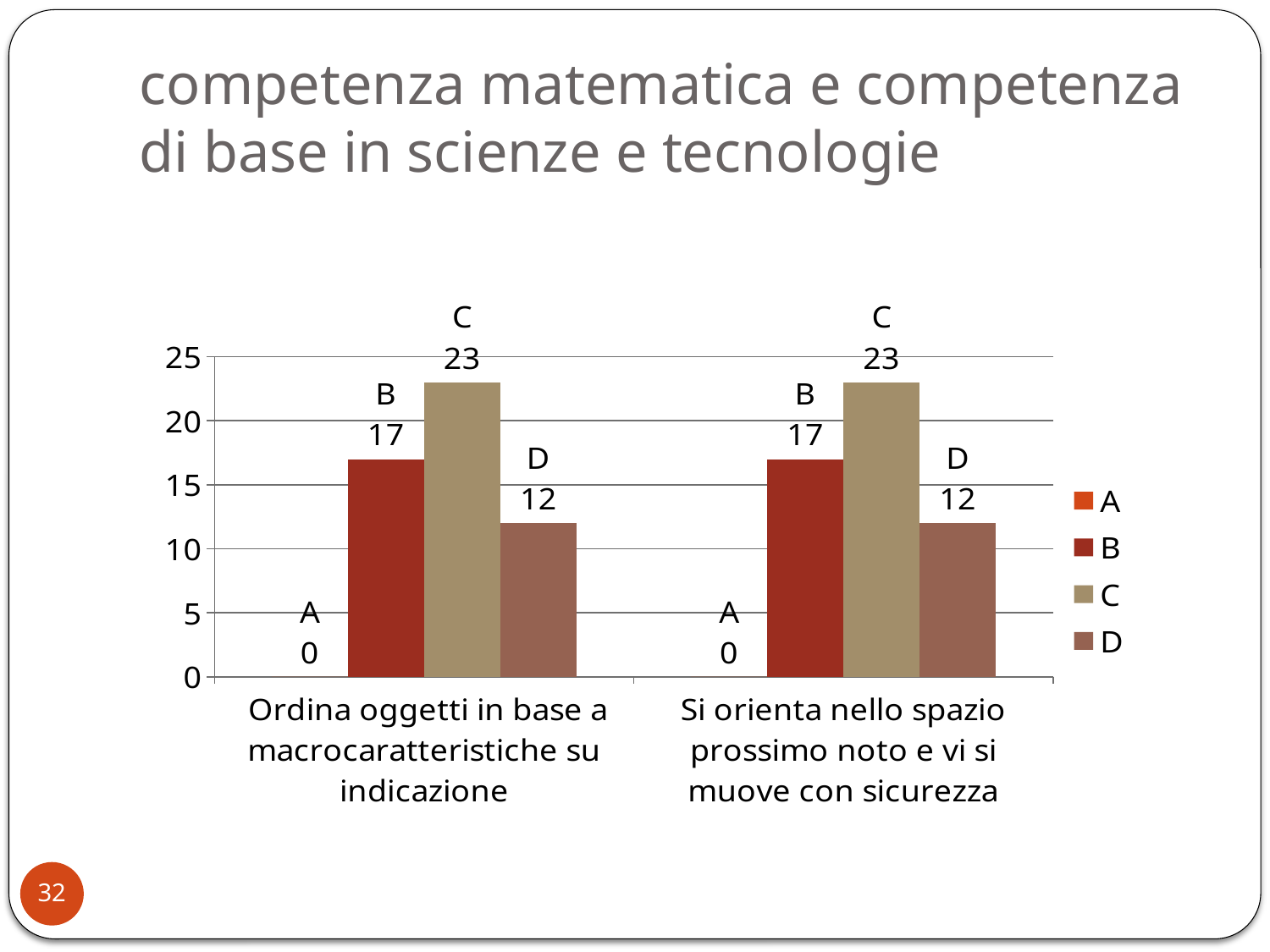
Which series has the lowest value in the category "Si orienta nello spazio prossimo noto e vi si muove con sicurezza"? A Which is larger in the category "Ordina oggetti in base a macrocaratteristiche su indicazione": the value for series B or the value for series D? B What is the difference between the values for series C and series D in the category "Ordina oggetti in base a macrocaratteristiche su indicazione"? 11 What is the value for series D in the category "Si orienta nello spazio prossimo noto e vi si muove con sicurezza"? 12 How many series does the legend list? 4 What is the value for series A in the category "Ordina oggetti in base a macrocaratteristiche su indicazione"? 0 What is the value for series C in the category "Ordina oggetti in base a macrocaratteristiche su indicazione"? 23 What is the difference between the values for series B and series D in the category "Si orienta nello spazio prossimo noto e vi si muove con sicurezza"? 5 How many categories are shown on the x axis of the chart? 2 What is the value for series B in the category "Si orienta nello spazio prossimo noto e vi si muove con sicurezza"? 17 Which series has the highest value in the category "Ordina oggetti in base a macrocaratteristiche su indicazione"? C What kind of chart is shown on the slide? bar chart